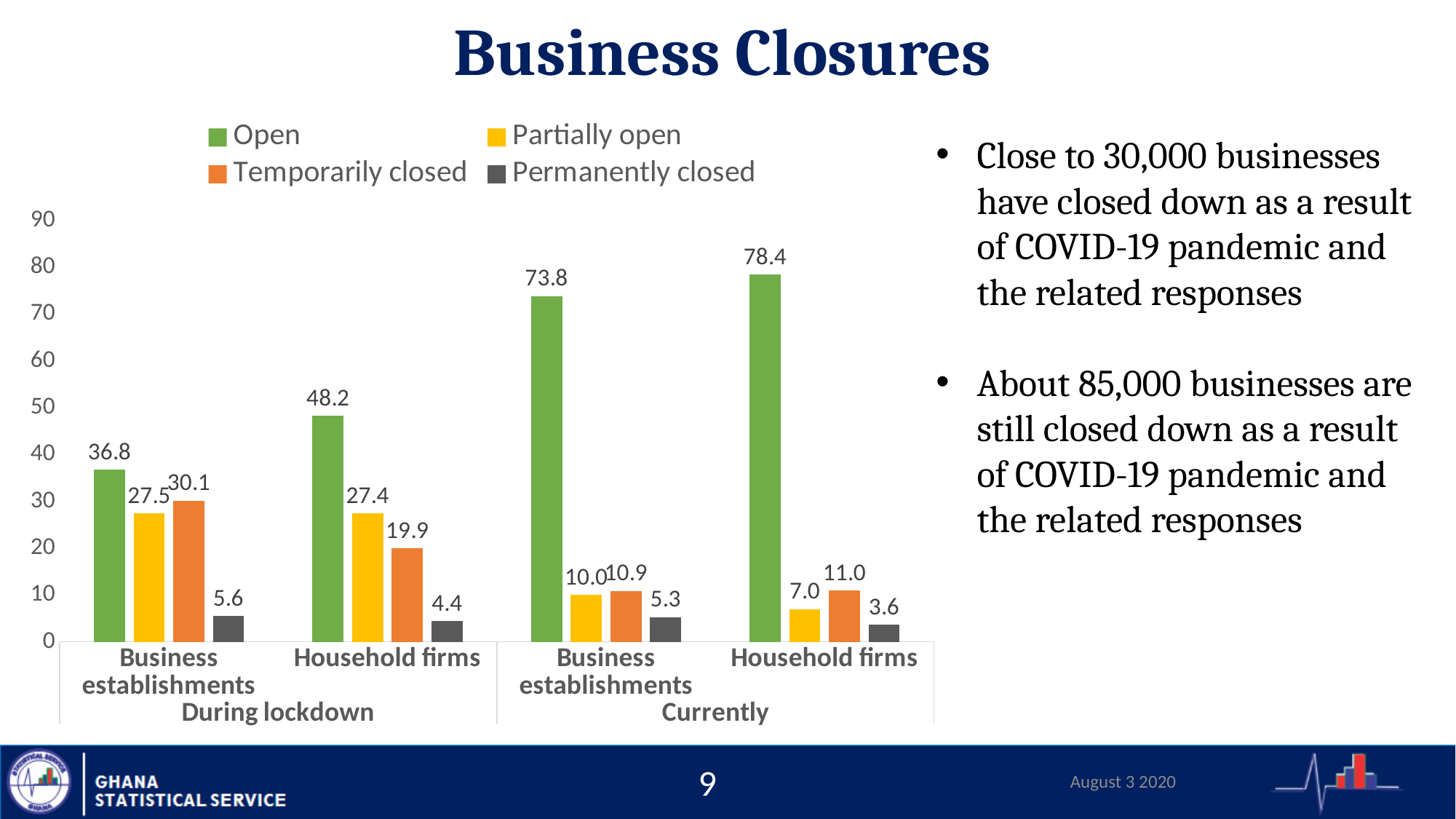
How many series does the legend list? 4 What colour represents the Temporarily closed series? orange Which is larger for Business establishments during lockdown: Partially open or Temporarily closed? Temporarily closed What is the difference between the Open values for Household firms currently and during lockdown? 30.2 What is the value for Permanently closed for Household firms currently? 3.6 What kind of chart is shown on the slide? bar chart What is the value for Open for Business establishments during lockdown? 36.8 Which category has the highest Open value? Household firms (Currently) Which category has the lowest Partially open value? Household firms (Currently) What is the value for Temporarily closed for Household firms during lockdown? 19.9 How many category groups are shown along the x axis? 4 Is the Open value for Business establishments currently greater or less than 70? greater